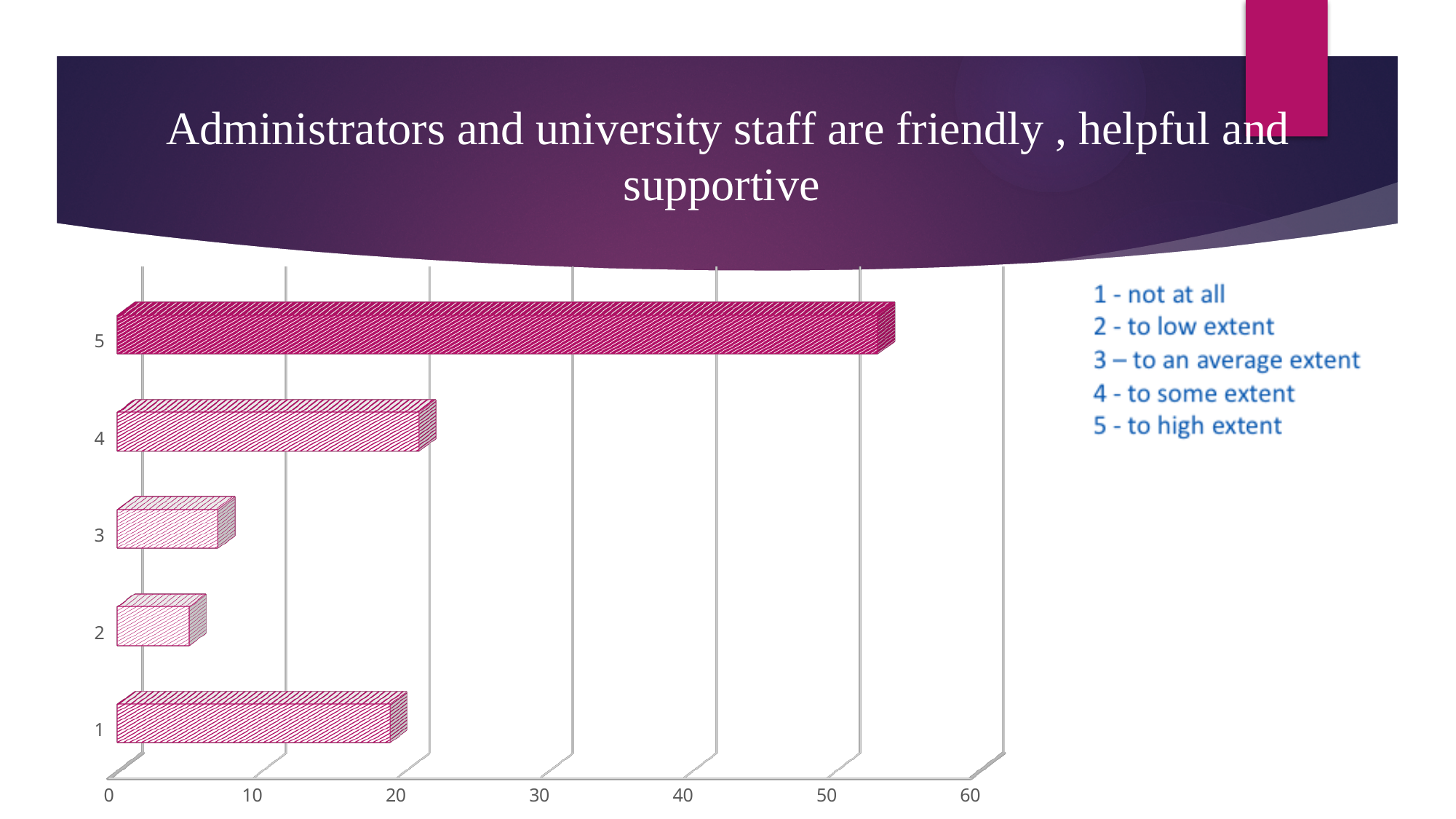
Is the value for category 1 greater or less than 10? greater According to the key on the slide, what does rating 5 stand for? to high extent Is the value for category 4 greater or less than 10? greater Which has a larger value, category 3 or category 1? 1 Is the value for category 5 greater or less than 40? greater Which has a larger value, category 5 or category 4? 5 Which category has the highest value? 5 What kind of chart is shown on the slide? bar chart How many categories are plotted on the chart? 5 Which category has the lowest value? 2